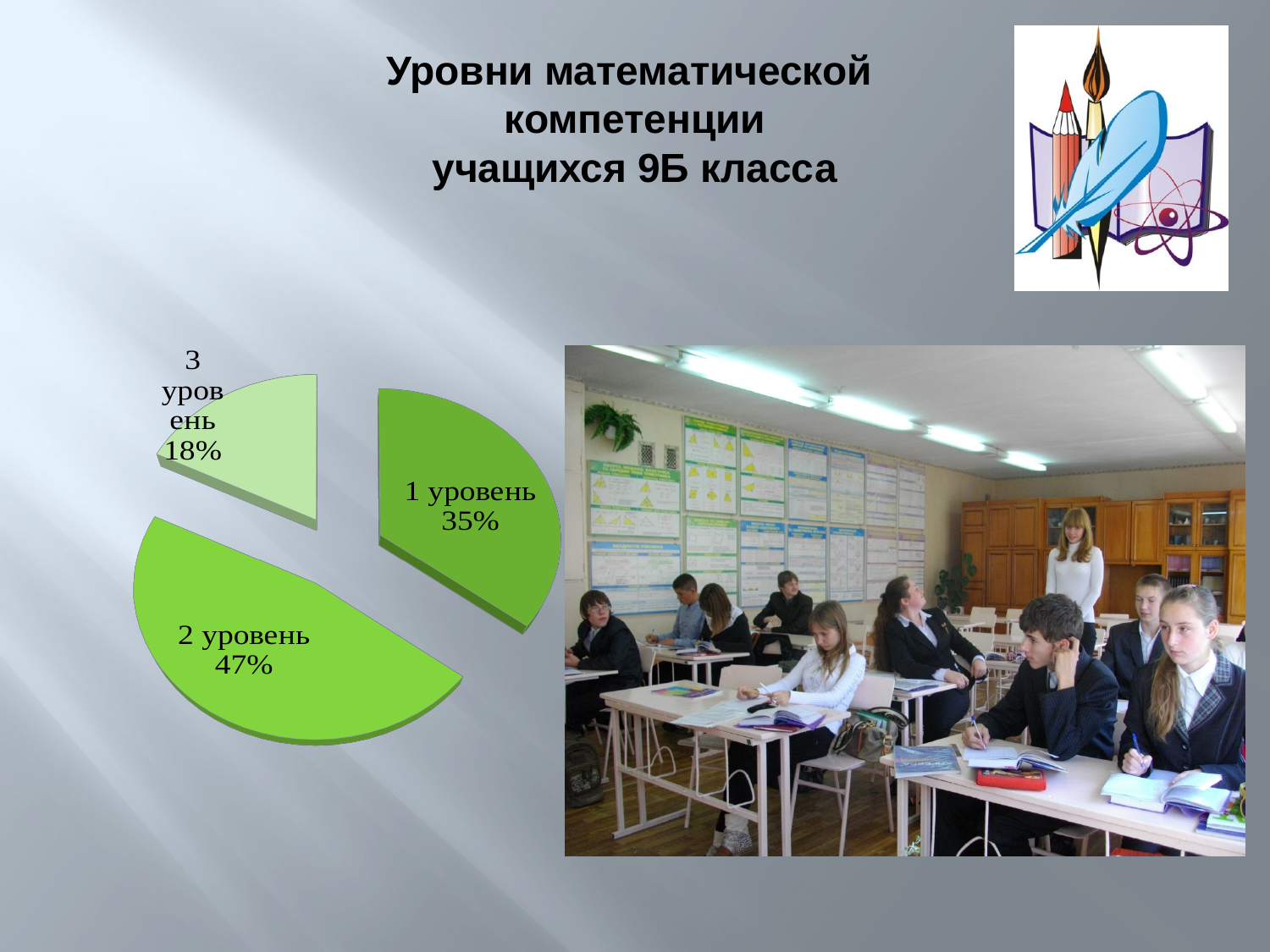
Which slice of the pie chart is the lightest green? 3 уровень What share of the pie does "2 уровень" have? 47% What is the title of the slide containing the pie chart? Уровни математической компетенции учащихся 9Б класса What type of chart is shown on the slide? pie chart What share of the pie does "3 уровень" have? 18% What share of the pie does "1 уровень" have? 35% Which level has the smallest share of the pie? 3 уровень Which is larger, the share for "1 уровень" or the share for "3 уровень"? 1 уровень What is the difference in percentage points between "2 уровень" and "1 уровень"? 12 What is the difference in percentage points between "1 уровень" and "3 уровень"? 17 How many slices does the pie chart have? 3 Which level has the largest share of the pie? 2 уровень